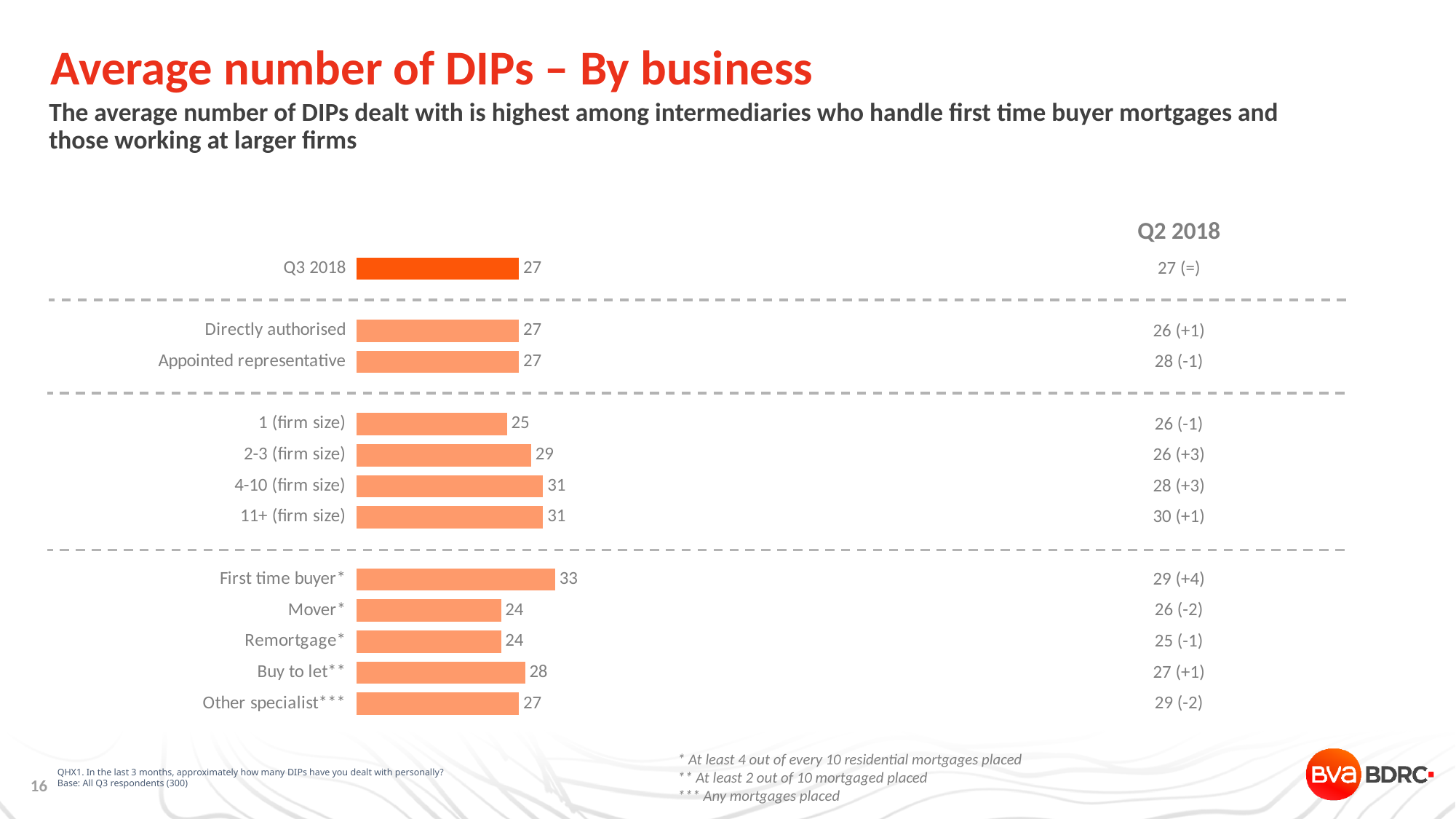
Which category has the highest average number of DIPs? First time buyer Which is larger, the value for 2-3 (firm size) or the value for 1 (firm size)? 2-3 (firm size) What is the value shown for Appointed representative? 27 Which is larger, the value for Buy to let or the value for Remortgage? Buy to let What is the value shown for Buy to let? 28 How many bars are plotted in the chart? 12 What kind of chart is shown on the slide? Bar chart What is the difference between the values for First time buyer and Mover? 9 What is the average number of DIPs for First time buyer in Q3 2018? 33 What Q2 2018 value is shown for First time buyer in the right-hand column? 29 (+4) What is the value shown for 1 (firm size)? 25 What is the difference between the values for 4-10 (firm size) and 1 (firm size)? 6